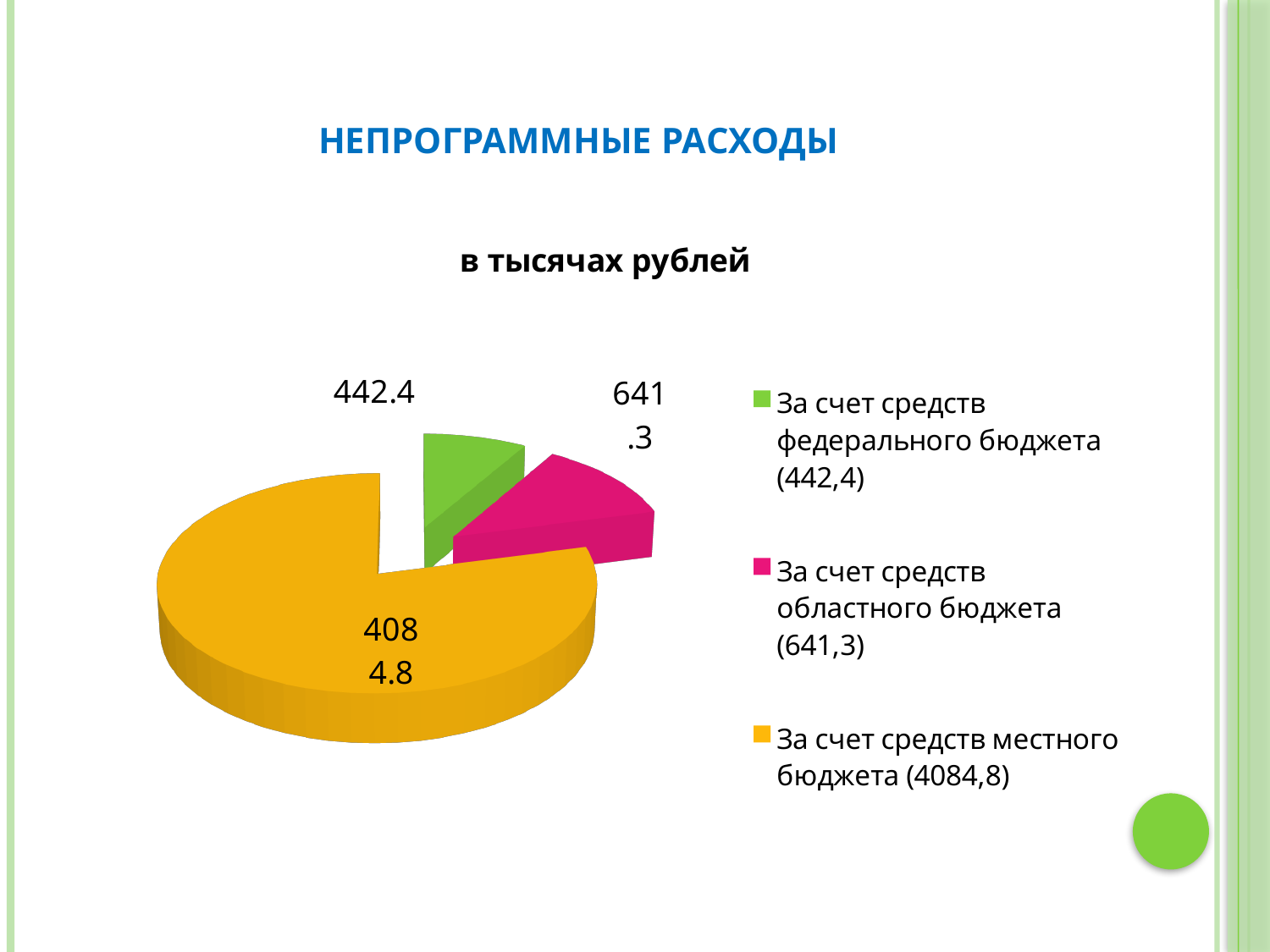
What is the value for 'За счет средств областного бюджета'? 641.3 What is the title of the chart? в тысячах рублей What is the value for 'За счет средств федерального бюджета'? 442.4 Which category has the smallest slice of the pie? За счет средств федерального бюджета What is the difference between the values for 'За счет средств областного бюджета' and 'За счет средств федерального бюджета'? 198.9 How many entries does the legend list? 3 What colour is the slice for 'За счет средств местного бюджета'? yellow Which category has the largest slice of the pie? За счет средств местного бюджета What kind of chart is shown on the slide? pie chart How many slices does the pie chart have? 3 Which is larger: the value for 'За счет средств областного бюджета' or 'За счет средств федерального бюджета'? За счет средств областного бюджета What is the value for 'За счет средств местного бюджета'? 4084.8